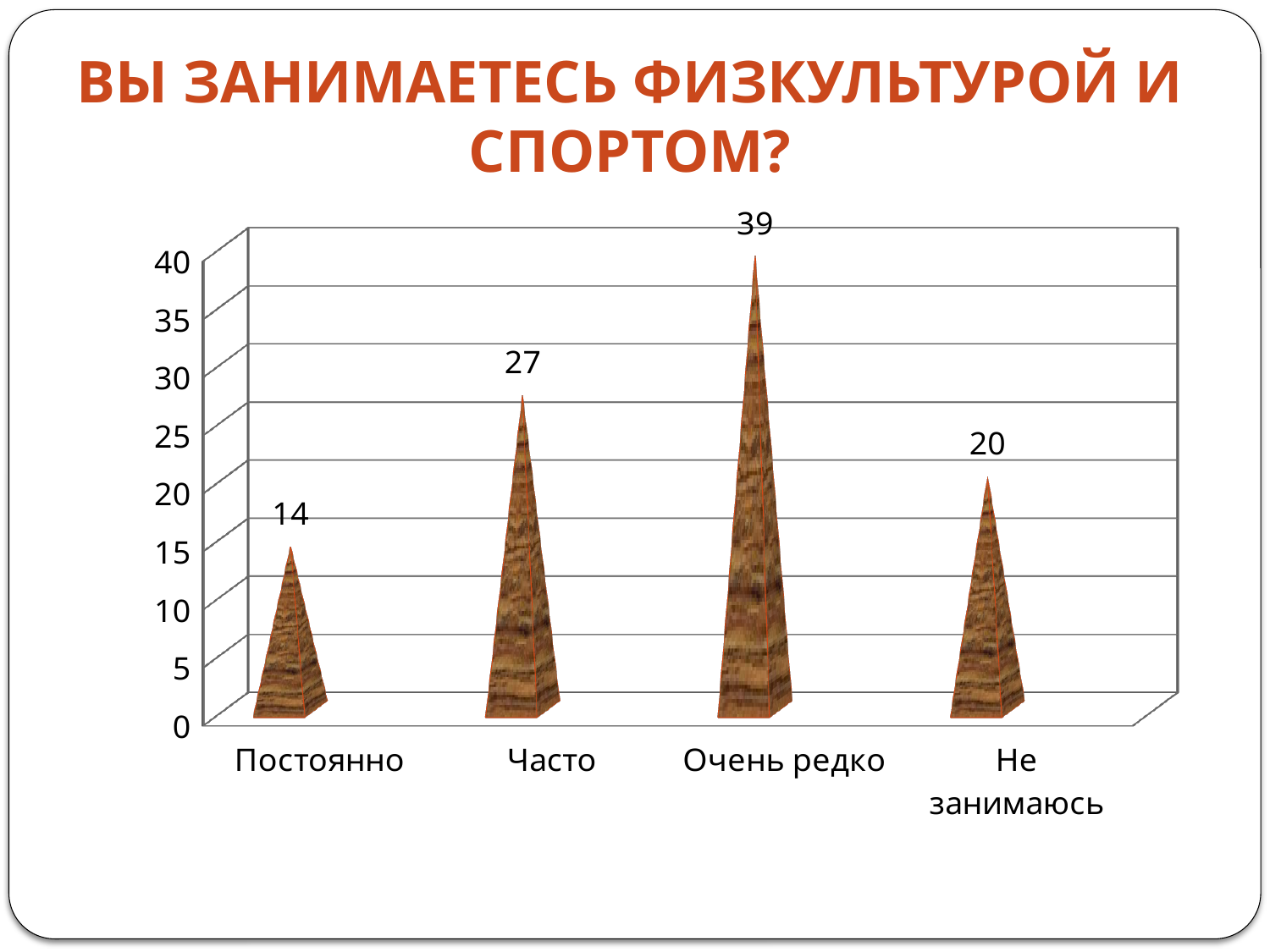
Which category has the highest value? Очень редко How many categories are shown on the x axis? 4 What is the value for Постоянно? 14 What is the value for Часто? 27 What is the value for Очень редко? 39 What kind of chart is shown on the slide? bar chart What is the difference between the values for Очень редко and Часто? 12 Is the value for Очень редко greater or less than 35? greater Which is larger, the value for Часто or the value for Не занимаюсь? Часто What is the difference between the values for Не занимаюсь and Постоянно? 6 What is the value for Не занимаюсь? 20 Which category has the lowest value? Постоянно